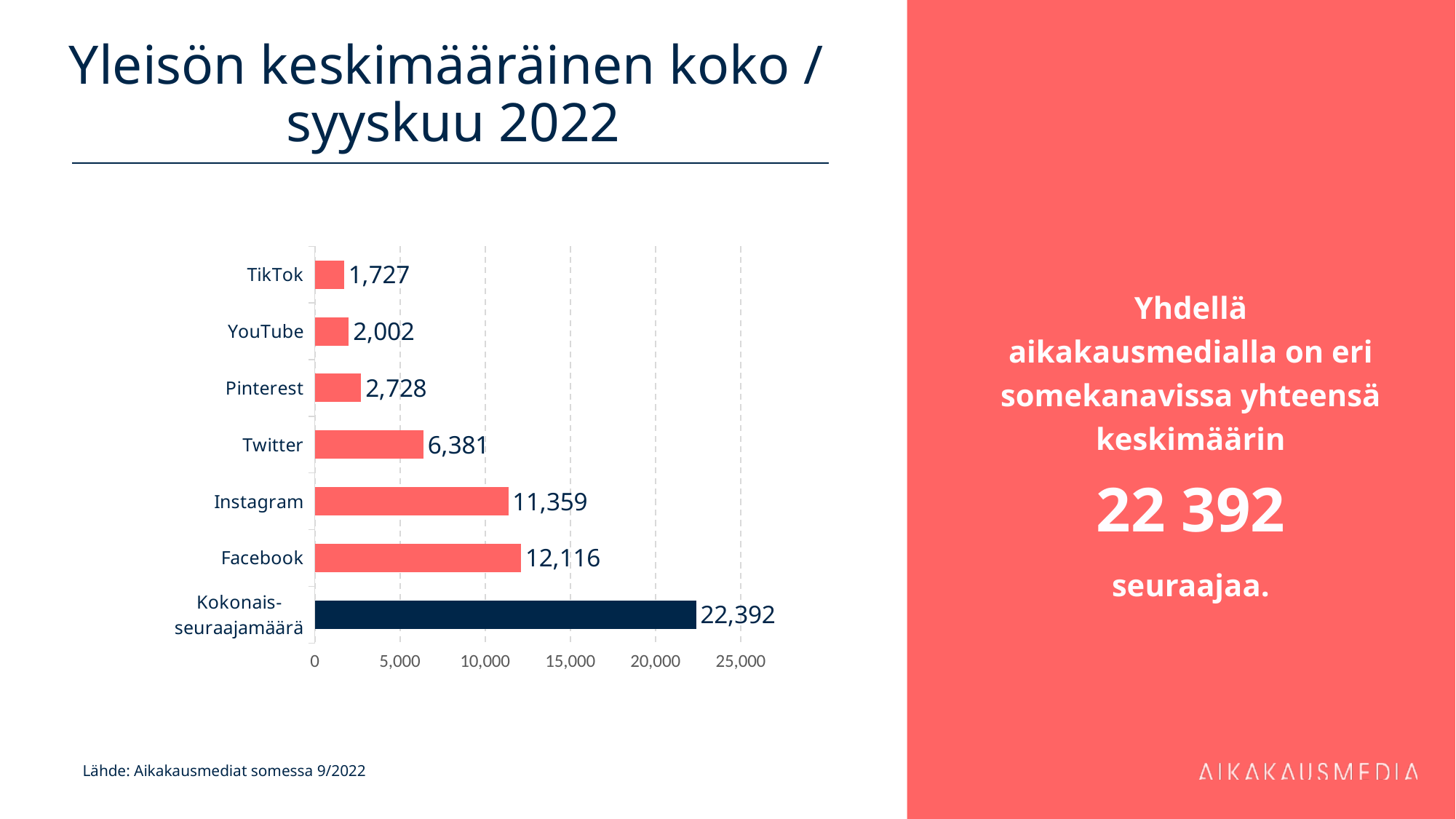
What kind of chart is shown on the slide? bar chart Which is larger, the value for Pinterest or the value for YouTube? Pinterest What is the value for Facebook? 12,116 What is the value for Kokonais-seuraajamäärä? 22,392 What is the value for TikTok? 1,727 What is the difference between the values for Facebook and Instagram? 757 What is the title of the slide? Yleisön keskimääräinen koko / syyskuu 2022 Is the value for Instagram greater or less than 10,000? greater Which category has the lowest value? TikTok What is the value for Twitter? 6,381 How many categories are shown in the chart? 7 Which category has the highest value? Kokonais-seuraajamäärä